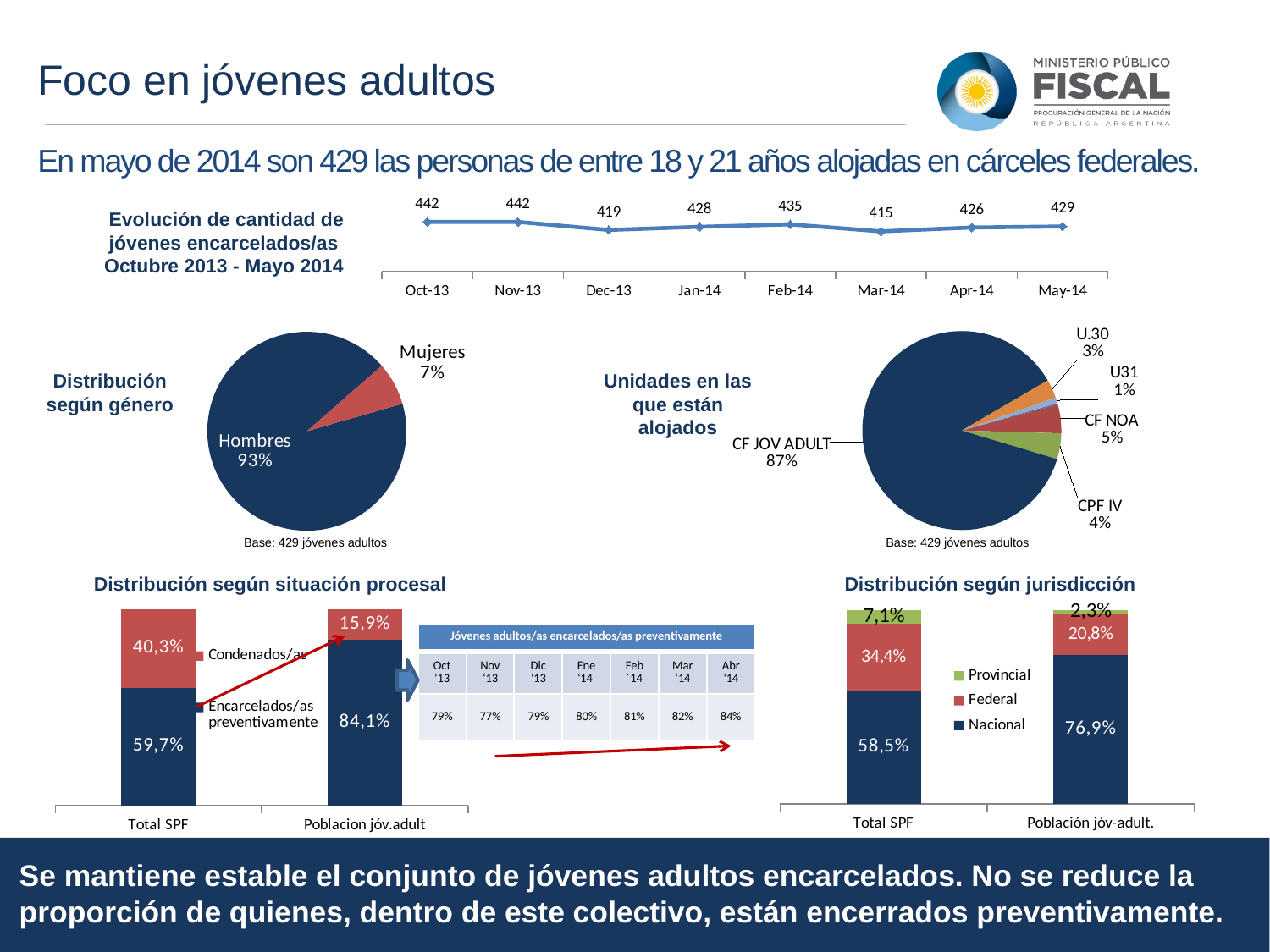
In the bar chart 'Distribución según situación procesal', what is the value for Encarcelados/as preventivamente in Poblacion jóv.adult? 84,1% In the bar chart 'Distribución según jurisdicción', how many series does the legend list? 3 In the bar chart 'Distribución según jurisdicción', what is the value for Federal in Total SPF? 34,4% In the pie chart 'Unidades en las que están alojados', what share is CF NOA? 5% In the line chart 'Evolución de cantidad de jóvenes encarcelados/as', which month has the lowest value? Mar-14 In the pie chart 'Distribución según género', what share is Mujeres? 7% In the line chart 'Evolución de cantidad de jóvenes encarcelados/as', which is larger, the value for Feb-14 or the value for Apr-14? Feb-14 In the line chart 'Evolución de cantidad de jóvenes encarcelados/as', what is the difference between the values for Jan-14 and Dec-13? 9 In the line chart 'Evolución de cantidad de jóvenes encarcelados/as', what is the value for May-14? 429 In the line chart 'Evolución de cantidad de jóvenes encarcelados/as', how many data points are plotted? 8